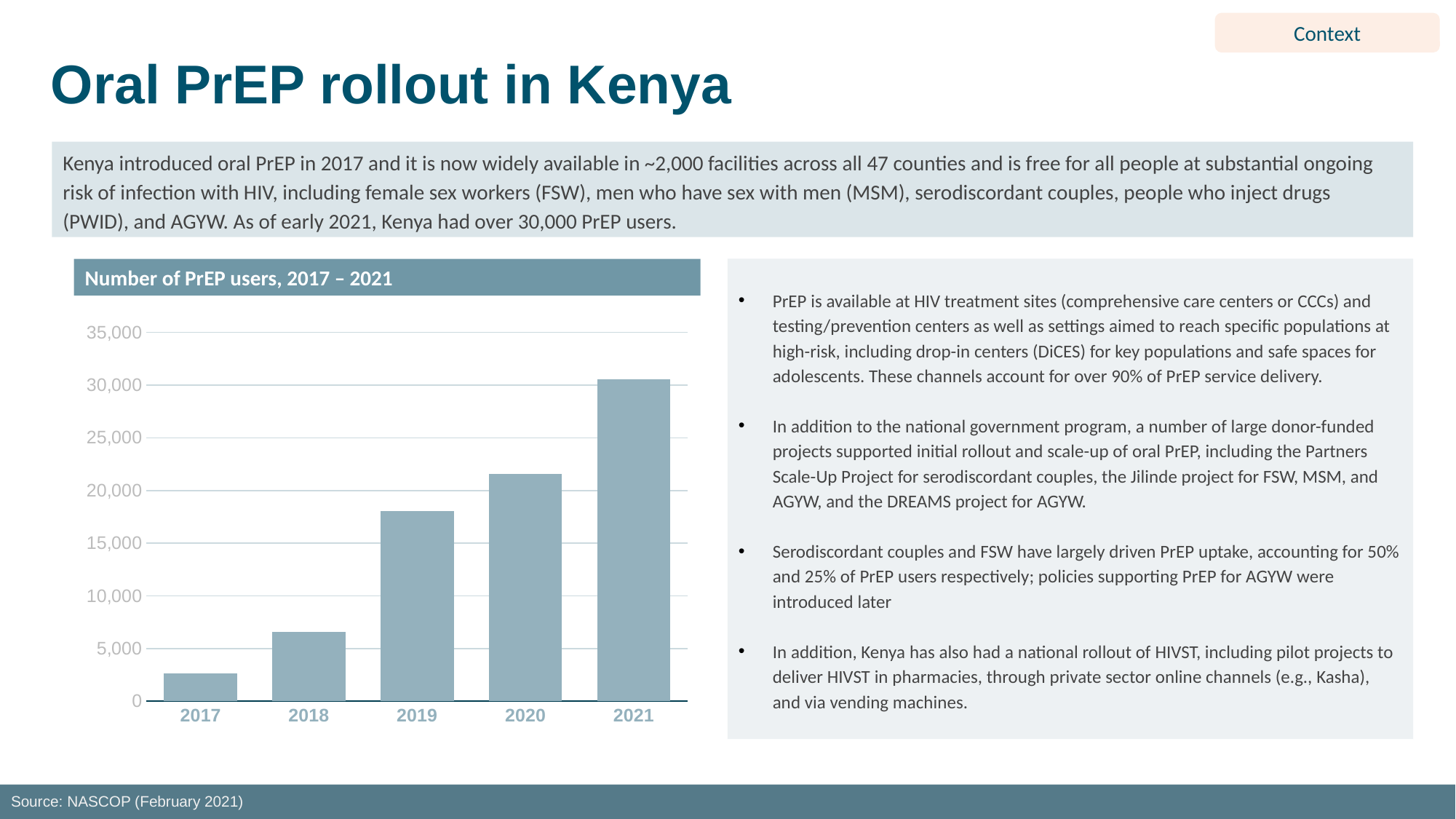
Is the number of PrEP users in 2017 greater or less than 5,000? less Which year has more PrEP users, 2018 or 2019? 2019 How many years are shown on the x axis of the chart? 5 Which year has the lowest number of PrEP users? 2017 Is the number of PrEP users in 2021 greater or less than 30,000? greater Is the number of PrEP users in 2018 greater or less than 10,000? less Do the number of PrEP users rise or fall from 2017 to 2021? Rise What is the title of the chart? Number of PrEP users, 2017 – 2021 Which year has the highest number of PrEP users? 2021 What type of chart is shown on the slide? Bar chart